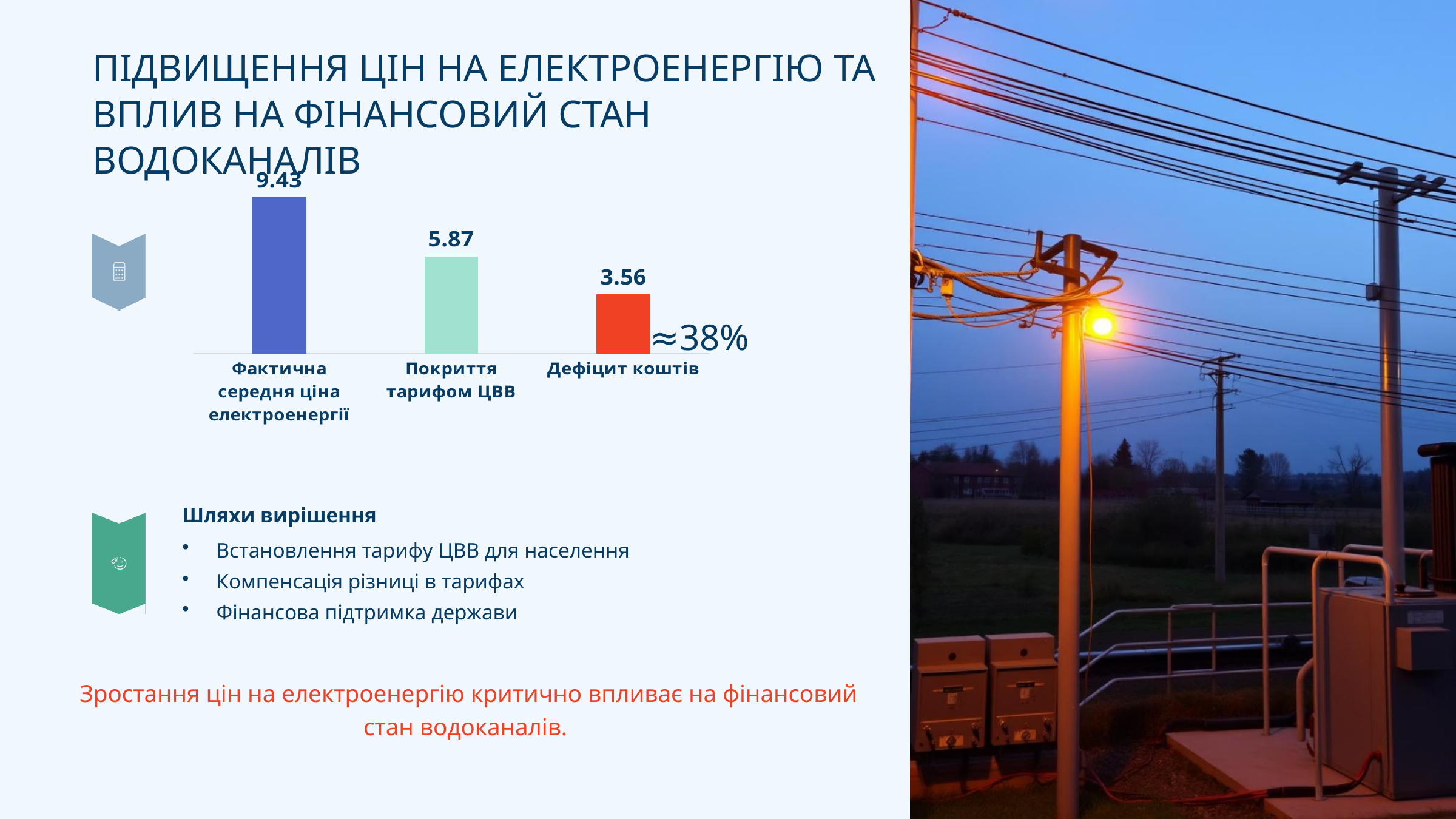
What is the difference between "Покриття тарифом ЦВВ" and "Дефіцит коштів"? 2.31 What is the value for "Покриття тарифом ЦВВ"? 5.87 What kind of chart is shown on the slide? Bar chart What is the value for "Дефіцит коштів"? 3.56 Which category has the lowest value? Дефіцит коштів What percentage annotation is shown next to the "Дефіцит коштів" bar? ≈38% Which category has the highest value? Фактична середня ціна електроенергії How many categories are shown in the chart? 3 Do the values rise or fall from left to right across the categories? Fall Which is larger, "Покриття тарифом ЦВВ" or "Дефіцит коштів"? Покриття тарифом ЦВВ What is the value for "Фактична середня ціна електроенергії"? 9.43 What is the difference between "Фактична середня ціна електроенергії" and "Покриття тарифом ЦВВ"? 3.56